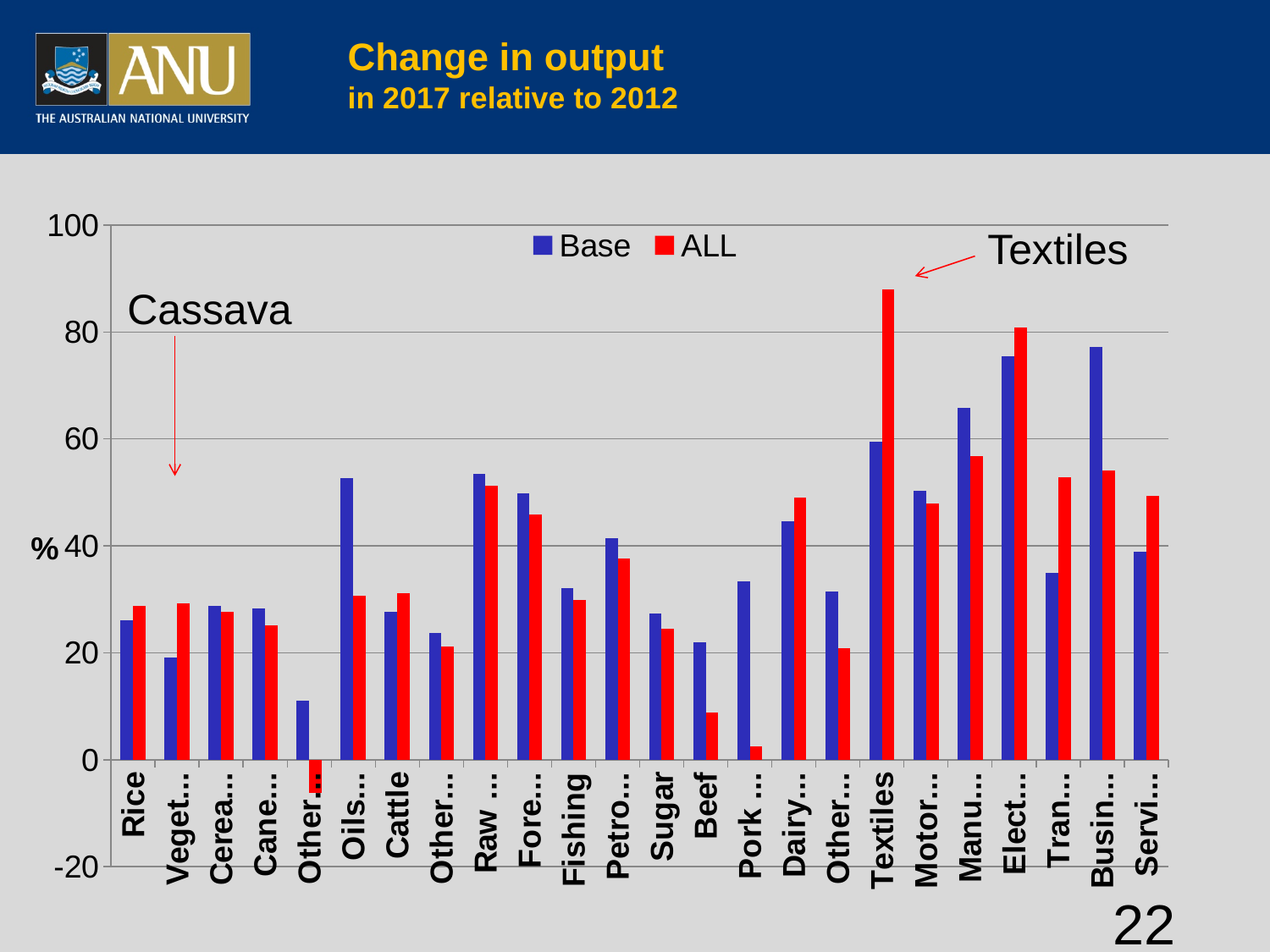
For Beef, which series has the larger value, Base or ALL? Base Is the ALL value for Beef greater or less than 20? less How many series does the legend list? 2 For Textiles, which series has the larger value, Base or ALL? ALL Which category has the highest ALL value? Textiles Is the Base value for Fishing greater or less than 40? less How many categories are plotted along the x axis? 24 Is the Base value for Rice greater or less than 20? greater What kind of chart is shown on the slide? bar chart What are the two series named in the legend? Base and ALL What is the title of the chart on the slide? Change in output in 2017 relative to 2012